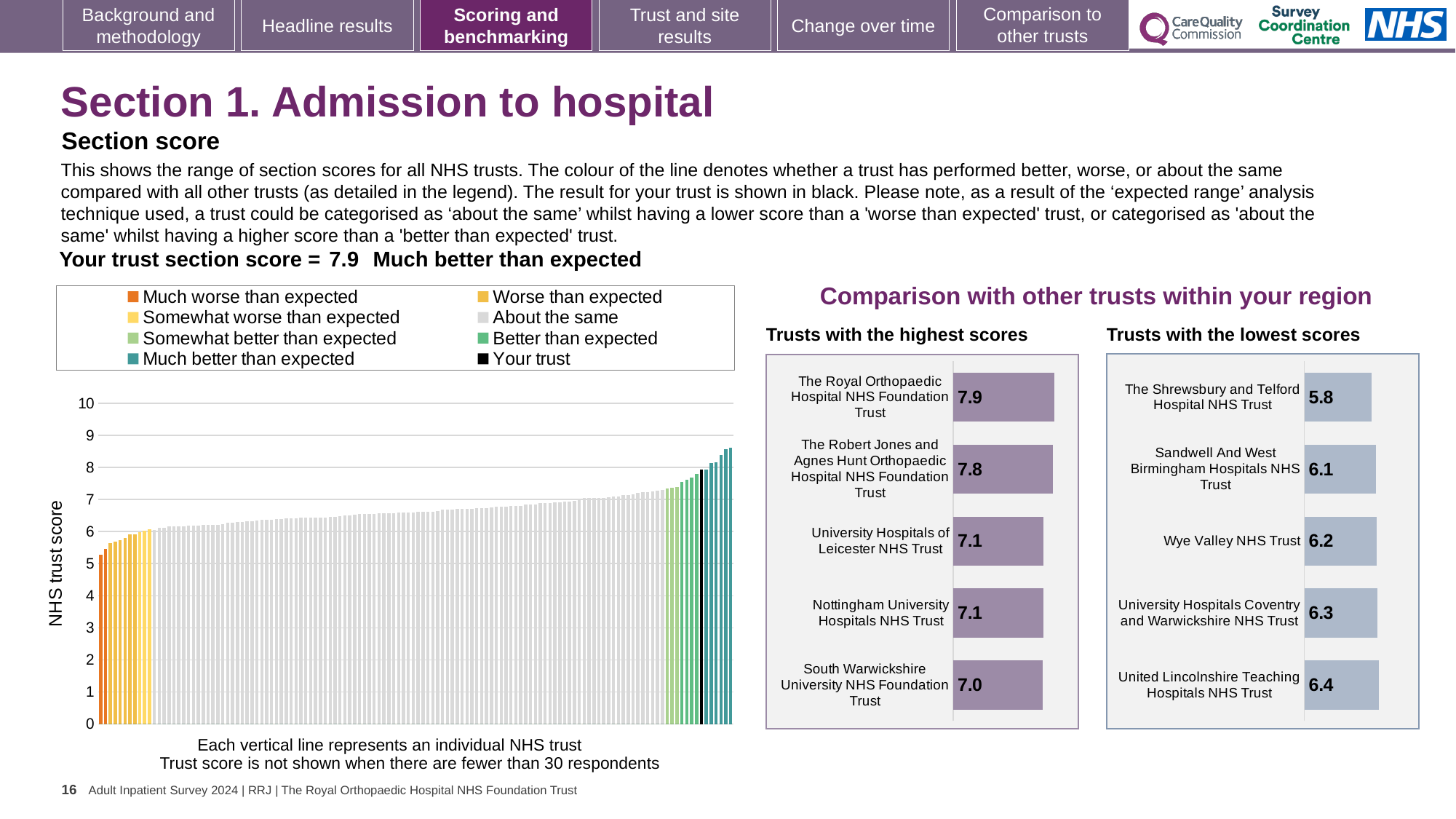
In the 'Trusts with the lowest scores' chart, which trust has the highest score? United Lincolnshire Teaching Hospitals NHS Trust In the NHS trust score chart on the left, do the bar values rise or fall from left to right? rise How many entries does the legend of the NHS trust score chart on the left list? 8 In the 'Trusts with the lowest scores' chart, which has the higher score: Sandwell And West Birmingham Hospitals NHS Trust or University Hospitals Coventry and Warwickshire NHS Trust? University Hospitals Coventry and Warwickshire NHS Trust In the 'Trusts with the lowest scores' chart, what is the difference between the scores of United Lincolnshire Teaching Hospitals NHS Trust and The Shrewsbury and Telford Hospital NHS Trust? 0.6 In the NHS trust score chart on the left, is the value of the leftmost (lowest) bar greater or less than 6? less How many trusts are listed in the 'Trusts with the highest scores' chart? 5 In the 'Trusts with the highest scores' chart, what is the difference between the scores of The Royal Orthopaedic Hospital NHS Foundation Trust and South Warwickshire University NHS Foundation Trust? 0.9 In the 'Trusts with the lowest scores' chart, what is the score for The Shrewsbury and Telford Hospital NHS Trust? 5.8 In the 'Trusts with the highest scores' chart, what is the score for The Royal Orthopaedic Hospital NHS Foundation Trust? 7.9 In the 'Trusts with the highest scores' chart, what is the score for South Warwickshire University NHS Foundation Trust? 7.0 In the 'Trusts with the lowest scores' chart, which trust has the lowest score? The Shrewsbury and Telford Hospital NHS Trust